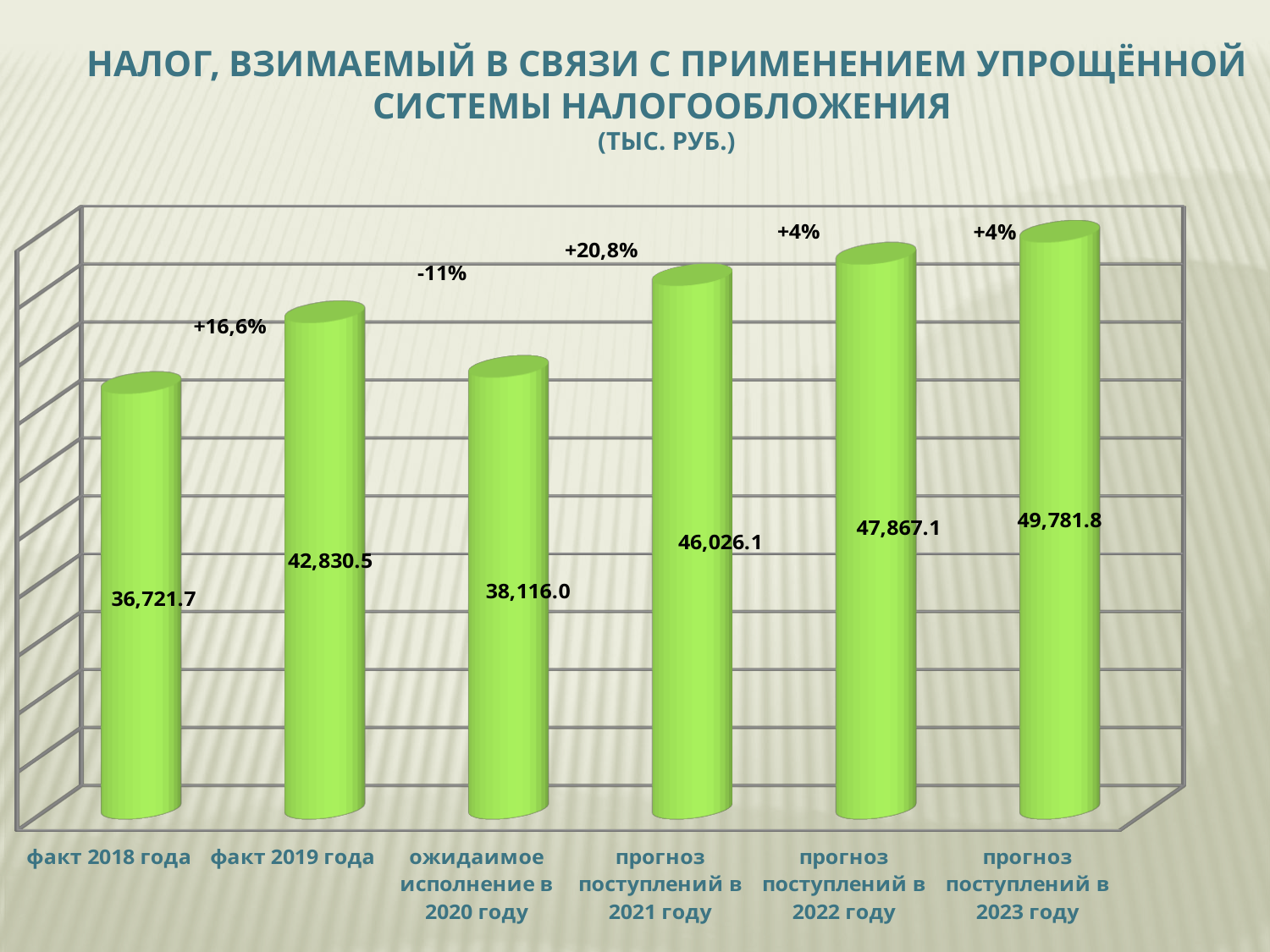
What is the value for факт 2018 года? 36,721.7 What percentage change is annotated above the bar for прогноз поступлений в 2021 году? +20,8% Which is larger, the value for факт 2019 года or the value for ожидаимое исполнение в 2020 году? факт 2019 года What kind of chart is shown on the slide? bar chart How many categories are shown in the chart? 6 Which category has the lowest value? факт 2018 года What is the difference between the values for прогноз поступлений в 2022 году and прогноз поступлений в 2021 году? 1,841.0 What is the value for прогноз поступлений в 2023 году? 49,781.8 What unit is given in the chart title? тыс. руб. Which category has the highest value? прогноз поступлений в 2023 году What is the value for факт 2019 года? 42,830.5 What is the value for ожидаимое исполнение в 2020 году? 38,116.0